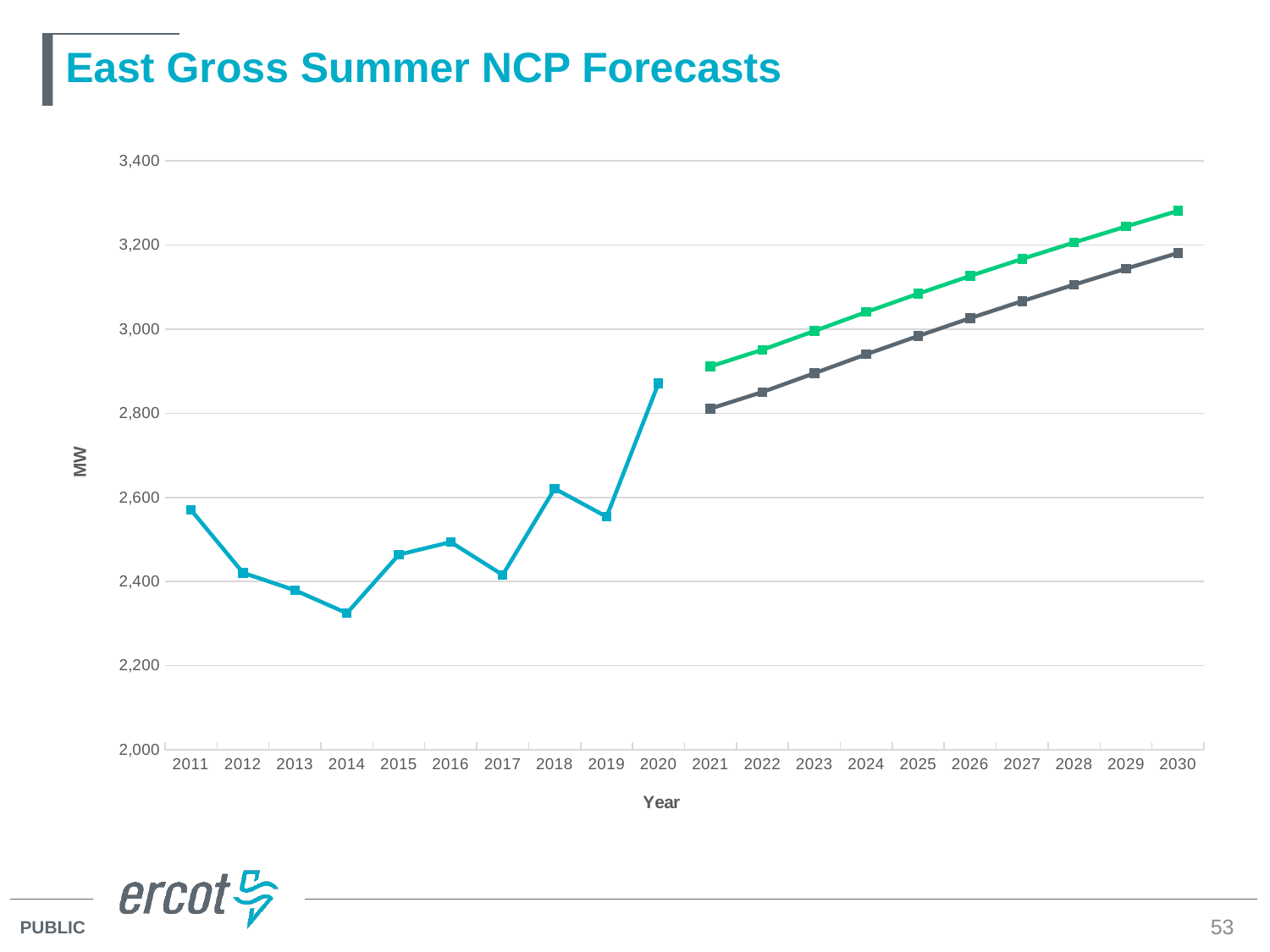
What kind of chart is shown on the slide? Line chart Is the green line's value for 2030 greater or less than 3,200? greater In 2030, which line has the higher value, the green line or the dark gray line? The green line How many lines are plotted on the chart? 3 In which year does the blue line reach its lowest value? 2014 Do the values of the green line rise or fall from 2021 to 2030? Rise What is the label on the vertical axis of the chart? MW Is the value for 2014 greater or less than 2,400? less Is the value for 2020 greater or less than 2,800? greater How many years are shown along the x axis of the chart? 20 What is the title of the chart? East Gross Summer NCP Forecasts In which year does the blue line reach its highest value? 2020